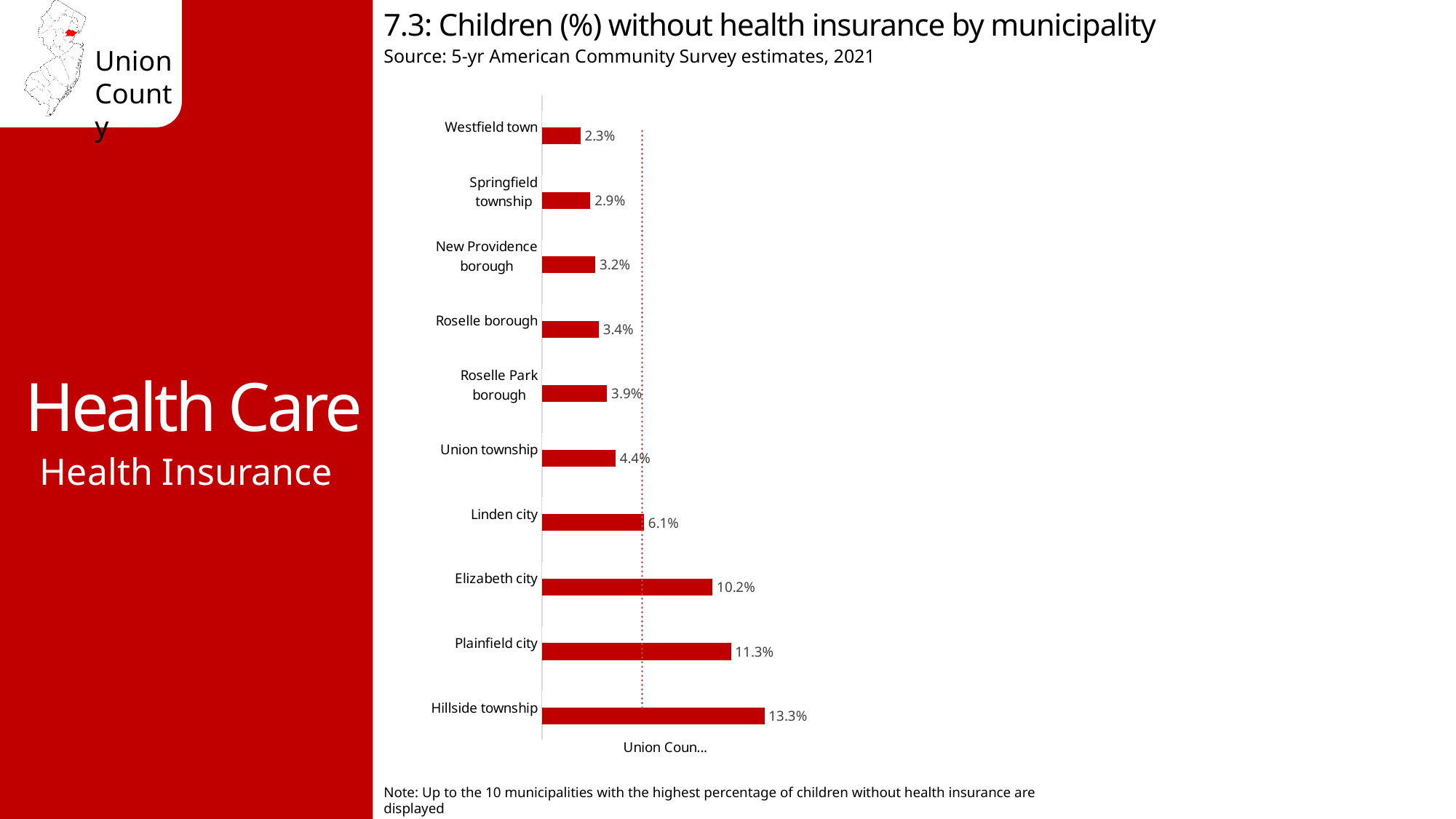
What is the value for Union township? 4.4% Which has a higher value, Roselle borough or Roselle Park borough? Roselle Park borough What percentage is shown for Westfield town? 2.3% Which municipality has the highest percentage of children without health insurance? Hillside township What type of chart is used on this slide? Bar chart What is the source of the data shown in the chart? 5-yr American Community Survey estimates, 2021 Which municipality has the lowest percentage of children without health insurance? Westfield town How many municipalities are shown in the chart? 10 What is the value shown for Elizabeth city? 10.2% What is the difference between the values for Hillside township and Plainfield city? 2.0% What is the difference between the values for Linden city and Union township? 1.7% What percentage of children are without health insurance in Hillside township? 13.3%